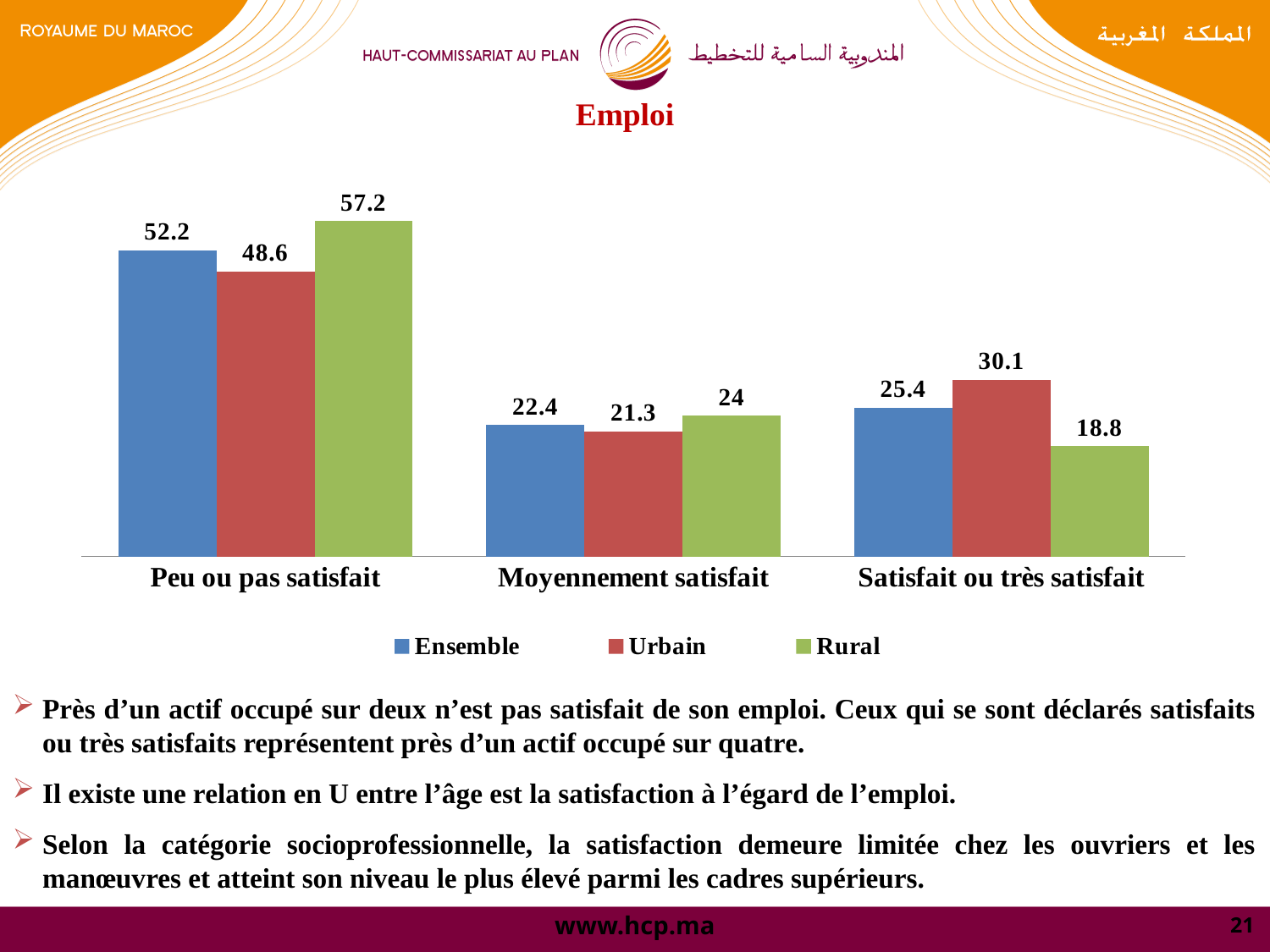
What is the value for Urbain in the 'Satisfait ou très satisfait' category? 30.1 Which is larger: the Ensemble value for 'Peu ou pas satisfait' or the Urbain value for 'Peu ou pas satisfait'? Ensemble What kind of chart is shown on the slide? Bar chart How many series does the legend list? 3 Which colour represents the Urbain series in the legend? Red What is the difference between the Urbain and Rural values in the 'Satisfait ou très satisfait' category? 11.3 What is the value for Ensemble in the 'Moyennement satisfait' category? 22.4 How many categories are shown on the x axis? 3 Which series has the lowest value in the 'Satisfait ou très satisfait' category? Rural What is the difference between the Rural and Urbain values in the 'Peu ou pas satisfait' category? 8.6 What is the value for Rural in the 'Peu ou pas satisfait' category? 57.2 Which series has the highest value in the 'Peu ou pas satisfait' category? Rural